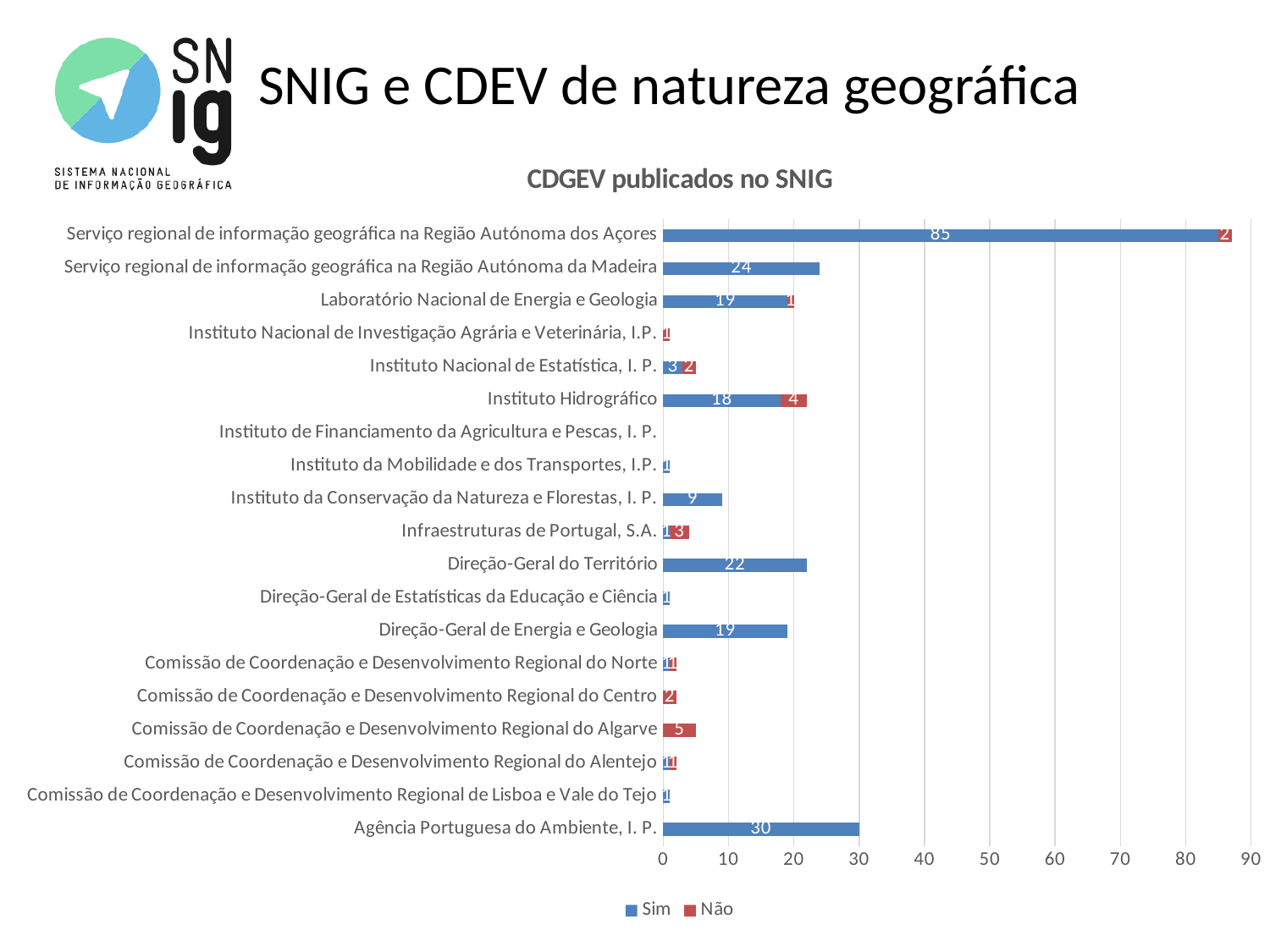
What is the 'Sim' value for Serviço regional de informação geográfica na Região Autónoma dos Açores? 85 What is the total of the stacked bar for Instituto Hidrográfico? 22 What kind of chart is shown on the slide? Stacked horizontal bar chart What is the title of the chart? CDGEV publicados no SNIG How many series does the legend list? 2 What is the difference between the 'Sim' values for Direção-Geral do Território and Direção-Geral de Energia e Geologia? 3 Which entity has the highest 'Não' value? Comissão de Coordenação e Desenvolvimento Regional do Algarve What is the 'Não' value for Instituto Hidrográfico? 4 Which entity has the highest 'Sim' value? Serviço regional de informação geográfica na Região Autónoma dos Açores Is the 'Sim' value for Serviço regional de informação geográfica na Região Autónoma dos Açores greater or less than 80? greater What is the 'Sim' value for Agência Portuguesa do Ambiente, I. P.? 30 Which has a larger 'Sim' value: Serviço regional de informação geográfica na Região Autónoma da Madeira or Agência Portuguesa do Ambiente, I. P.? Agência Portuguesa do Ambiente, I. P.